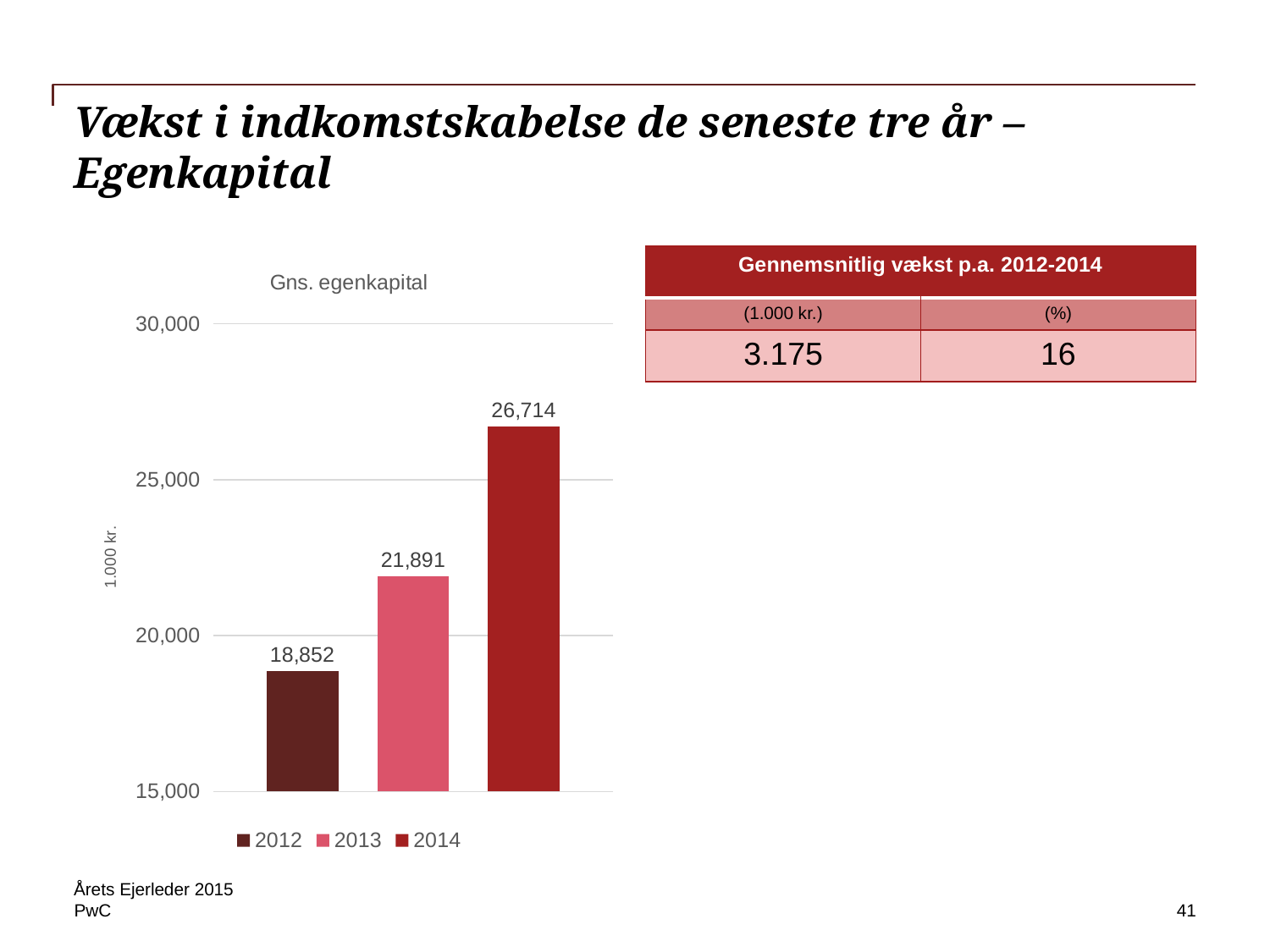
Which year has the lowest value in the Gns. egenkapital chart? 2012 What is the value for 2014 in the Gns. egenkapital chart? 26,714 What is the value for 2012 in the Gns. egenkapital chart? 18,852 How many bars are shown in the Gns. egenkapital chart? 3 Which is larger in the Gns. egenkapital chart, the value for 2013 or the value for 2014? 2014 What is the value for 2013 in the Gns. egenkapital chart? 21,891 Which year has the highest value in the Gns. egenkapital chart? 2014 Is the value for 2013 in the Gns. egenkapital chart greater or less than 20,000? greater What kind of chart is the Gns. egenkapital chart? bar chart Do the values in the Gns. egenkapital chart rise or fall from 2012 to 2014? rise What is the difference between the 2014 and 2012 values in the Gns. egenkapital chart? 7,862 What is the difference between the 2013 and 2012 values in the Gns. egenkapital chart? 3,039